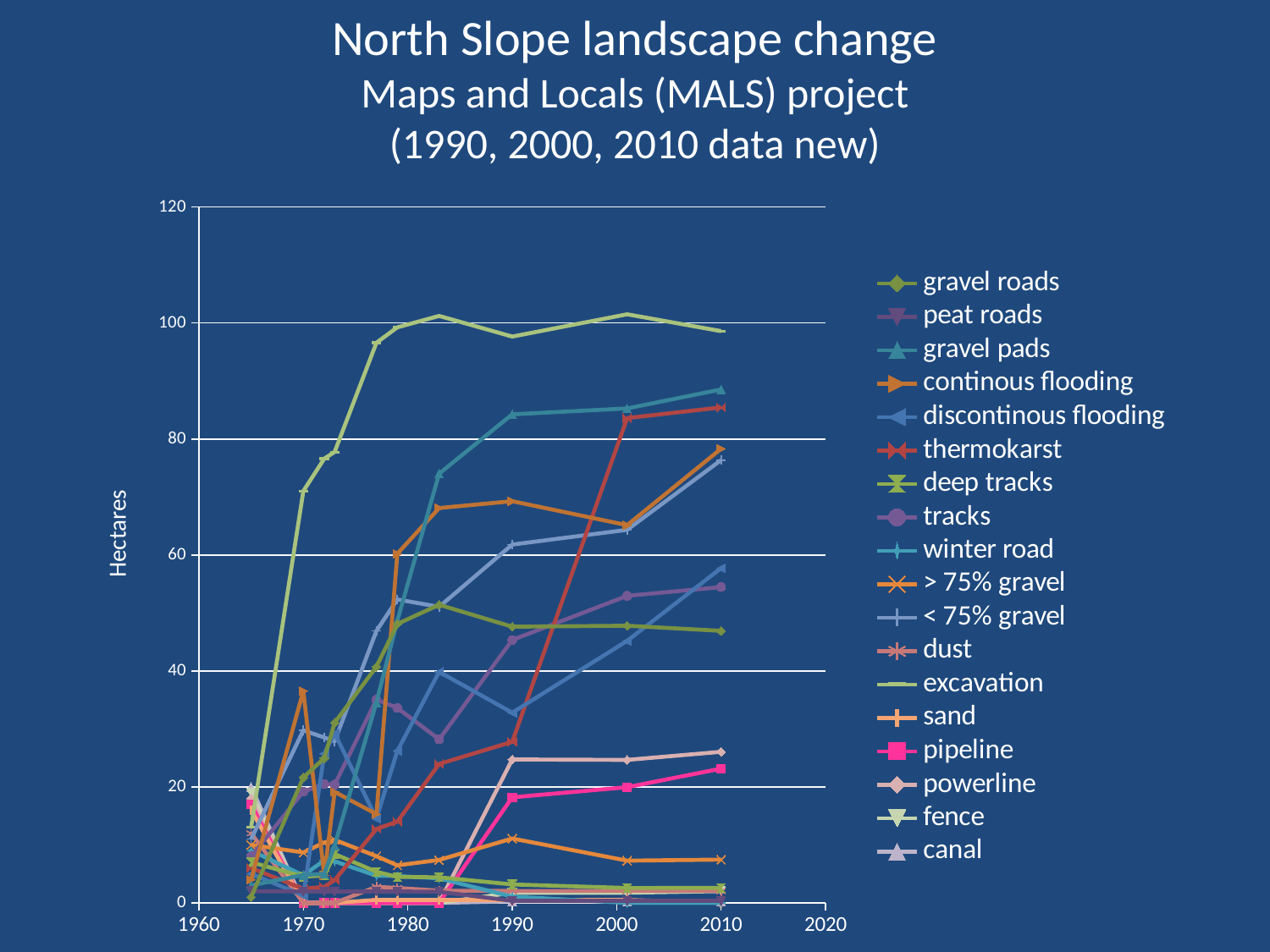
Is the value for powerline in 2010 greater or less than 20? greater What is the highest value shown on the vertical axis? 120 Is the value for gravel pads in 2010 greater or less than 80? greater Does the pipeline series rise or fall between 1990 and 2010? rise How many series does the legend list? 18 In 2010, which is larger: thermokarst or powerline? thermokarst Is the value for gravel roads in 2010 greater or less than 60? less In 2010, which is larger: gravel pads or pipeline? gravel pads What kind of chart is shown on the slide? line chart What is the label of the vertical axis? Hectares